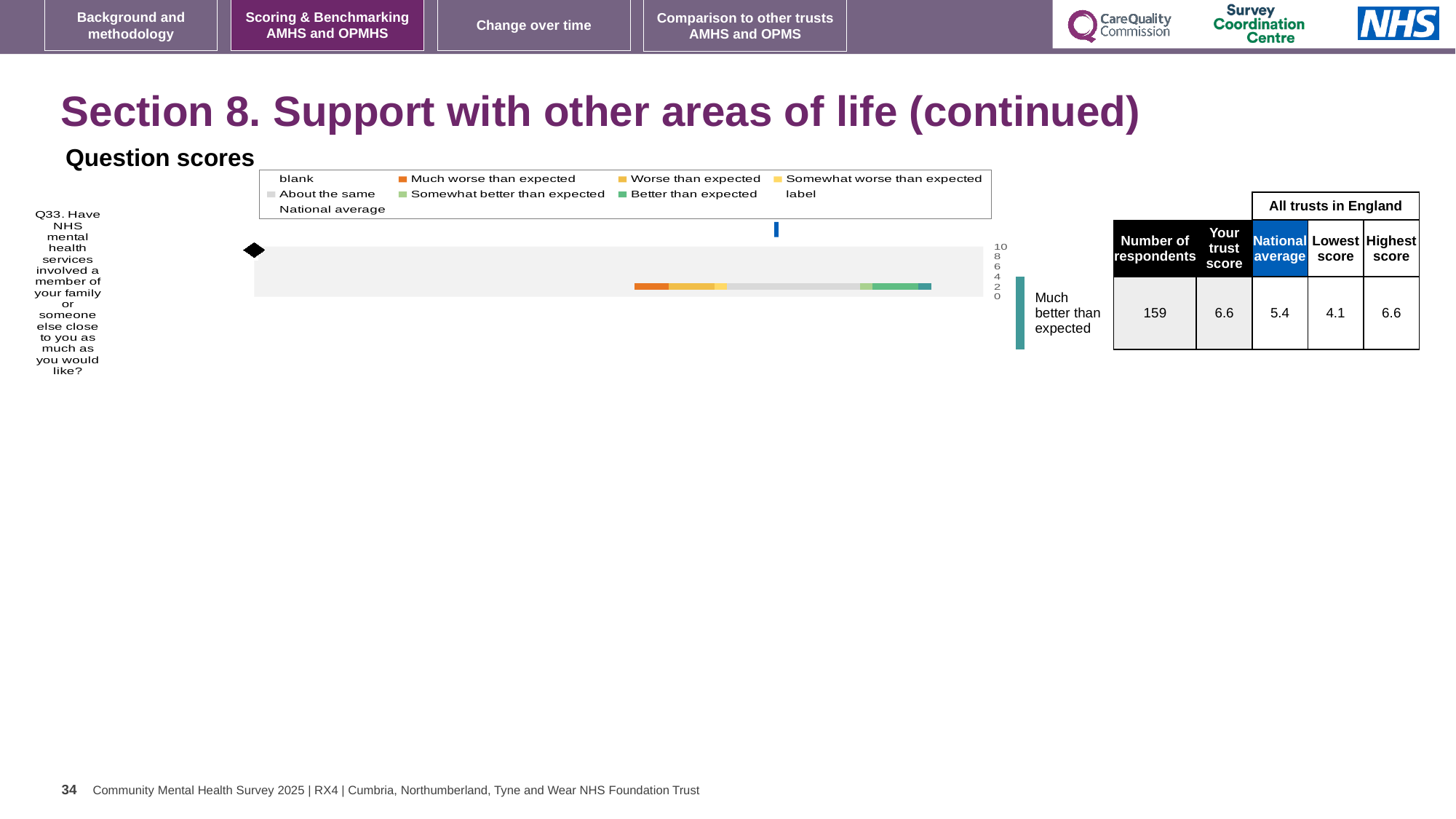
What is the Highest score among all trusts in England for Q33? 6.6 What is the Lowest score among all trusts in England for Q33? 4.1 What benchmark category label is shown next to the chart for Q33? Much better than expected What is the National average score shown for Q33? 5.4 How many respondents are shown for Q33? 159 How many questions (categories) are plotted on the chart? 1 What is the difference between the Highest score and the Lowest score for Q33? 2.5 Which is larger for Q33, the trust score or the National average? trust score What is the 'Your trust score' value shown for Q33? 6.6 What is the difference between the trust score and the National average for Q33? 1.2 How many entries does the chart legend list? 9 What kind of chart is used to show the question score for Q33? bar chart